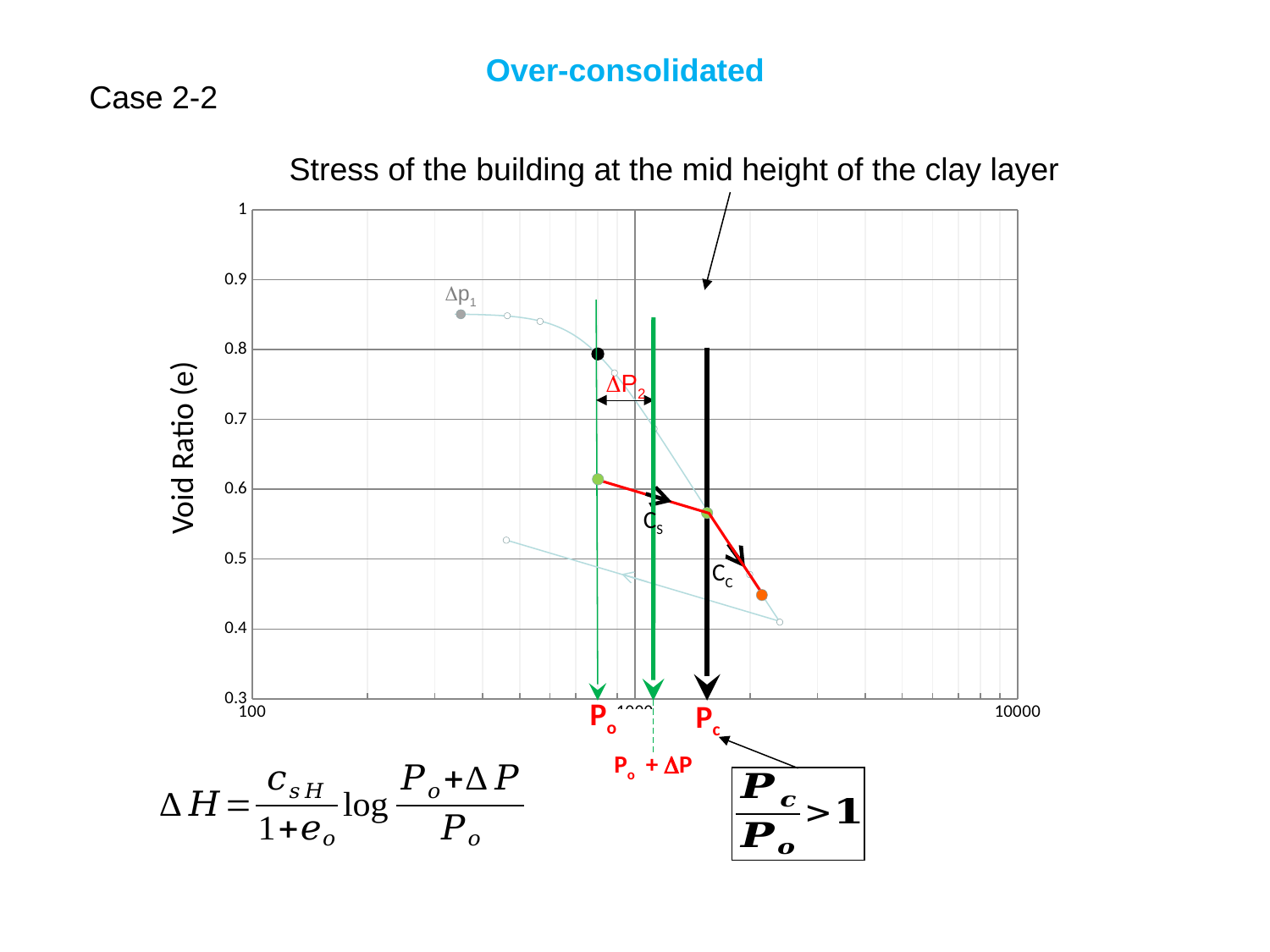
What is the title of the vertical axis? Void Ratio (e) What is the lowest value shown on the horizontal axis? 100 What is the highest value shown on the horizontal axis? 10000 Is the void ratio of the green point on the Po line greater or less than 0.7? less Is the void ratio of the black point on the Po line greater or less than 0.7? greater Which point has the higher void ratio, the point labelled Δp1 or the orange point at the end of the Cc line? Δp1 Which labelled stress is larger on the horizontal axis, Po or Pc? Pc What kind of chart is shown on the slide? line chart Is the void ratio of the point labelled Δp1 greater or less than 0.8? greater Along the red line from Po to Pc and beyond, does the void ratio rise or fall as stress increases? fall What is the lowest value shown on the vertical axis? 0.3